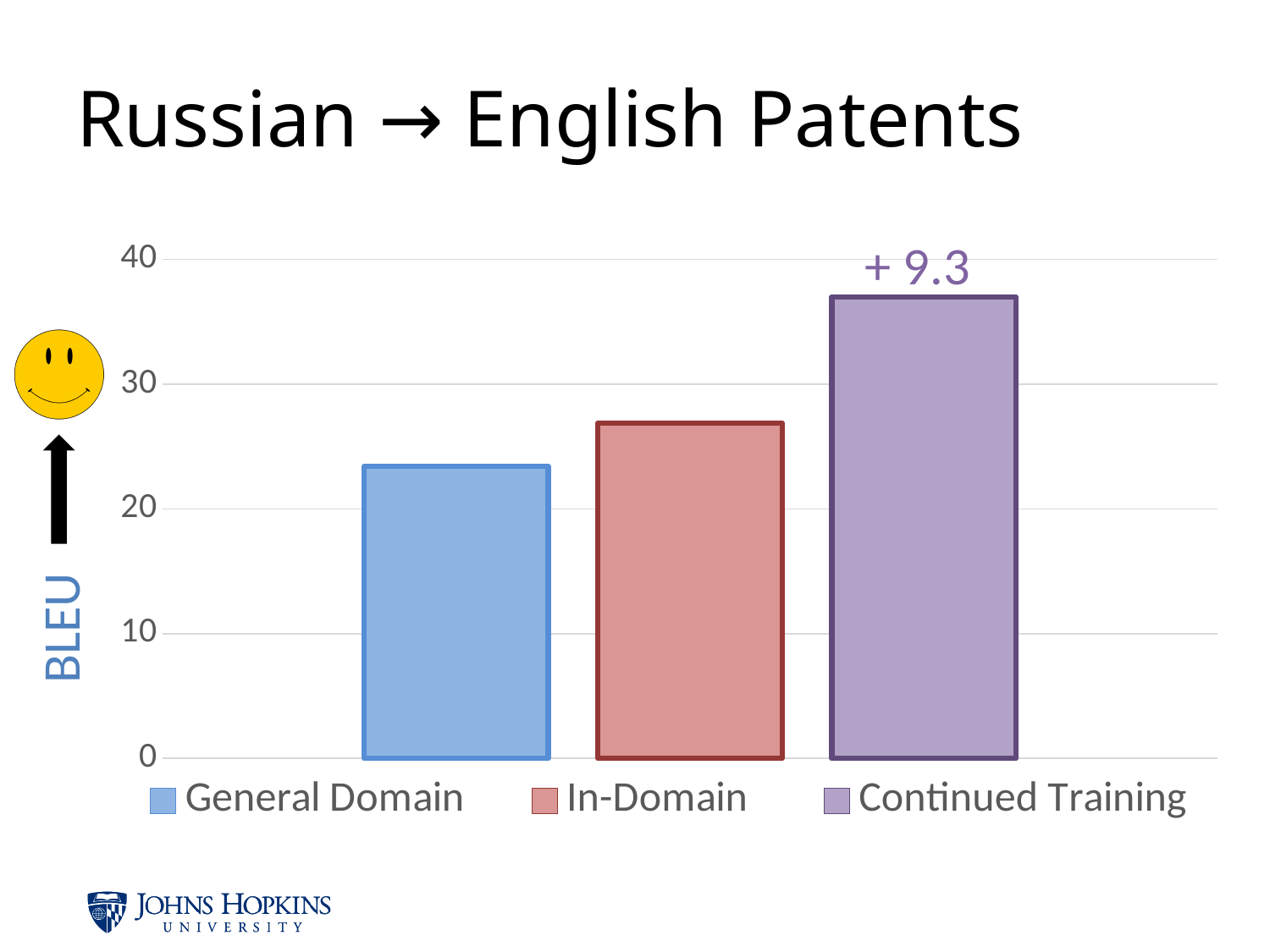
What kind of chart is shown on the slide? bar chart What is the title of the slide containing the chart? Russian → English Patents Which series has the highest BLEU score? Continued Training What annotation is printed above the Continued Training bar? + 9.3 Which series has the lowest BLEU score? General Domain Is the BLEU score for Continued Training greater or less than 30? greater Which has a higher BLEU score, In-Domain or General Domain? In-Domain Is the BLEU score for General Domain greater or less than 30? less How many bars are plotted in the chart? 3 Is the BLEU score for In-Domain greater or less than 20? greater How many series does the legend list? 3 Do the bar values rise or fall from left to right across the chart? rise